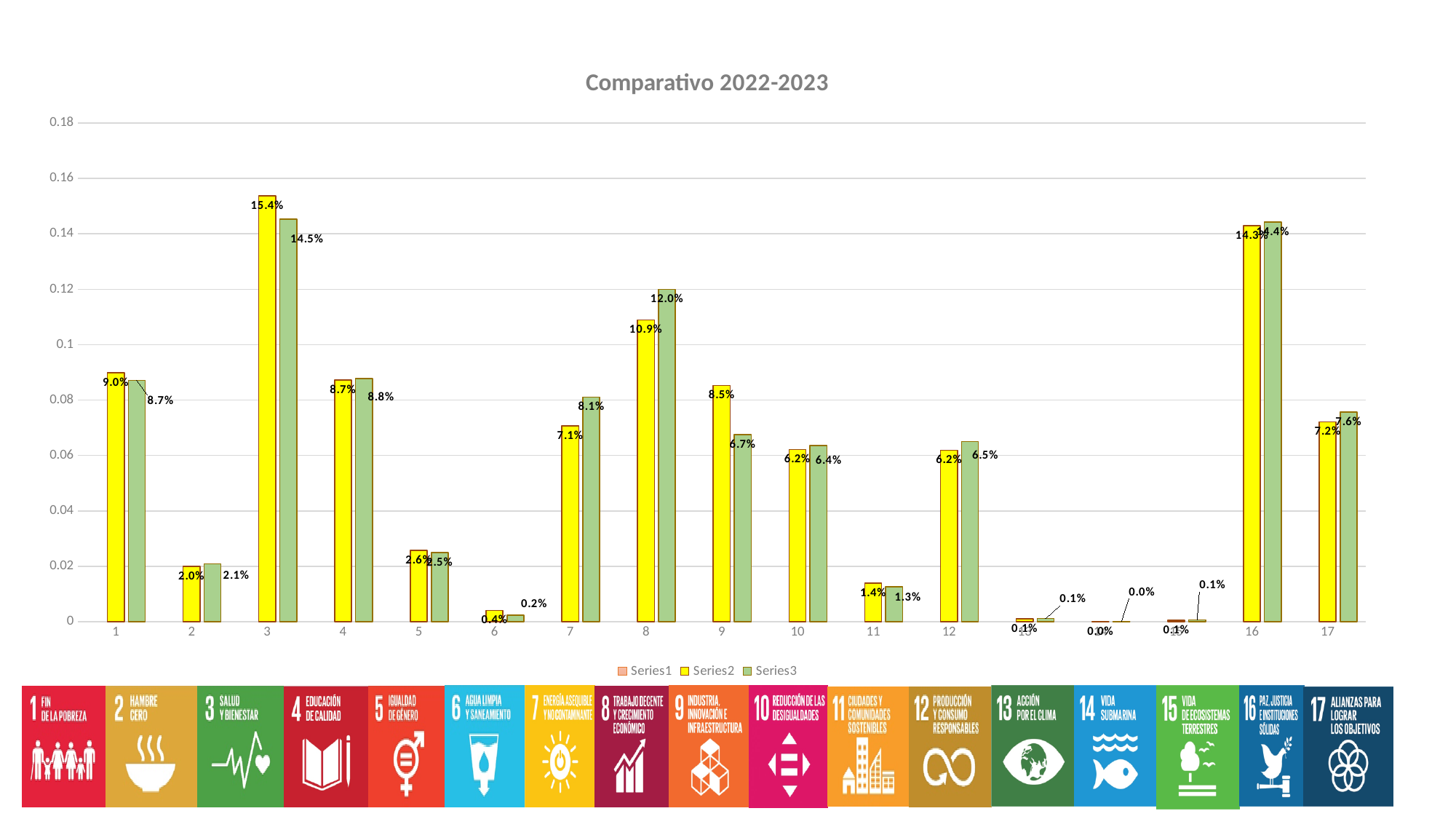
Is the Series3 value for category 16 greater or less than 0.12? greater Which category has the highest Series3 value? 3 What is the difference between the Series2 and Series3 values for category 9? 1.8% Which category has the highest Series2 value? 3 What is the Series2 value for category 3? 15.4% How many series does the legend list? 3 What is the Series2 value for category 17? 7.2% What is the title of the chart? Comparativo 2022-2023 What kind of chart is shown on the slide? bar chart For category 7, which is larger: the Series2 value or the Series3 value? Series3 What is the Series3 value for category 8? 12.0% How many categories are shown on the x axis? 17